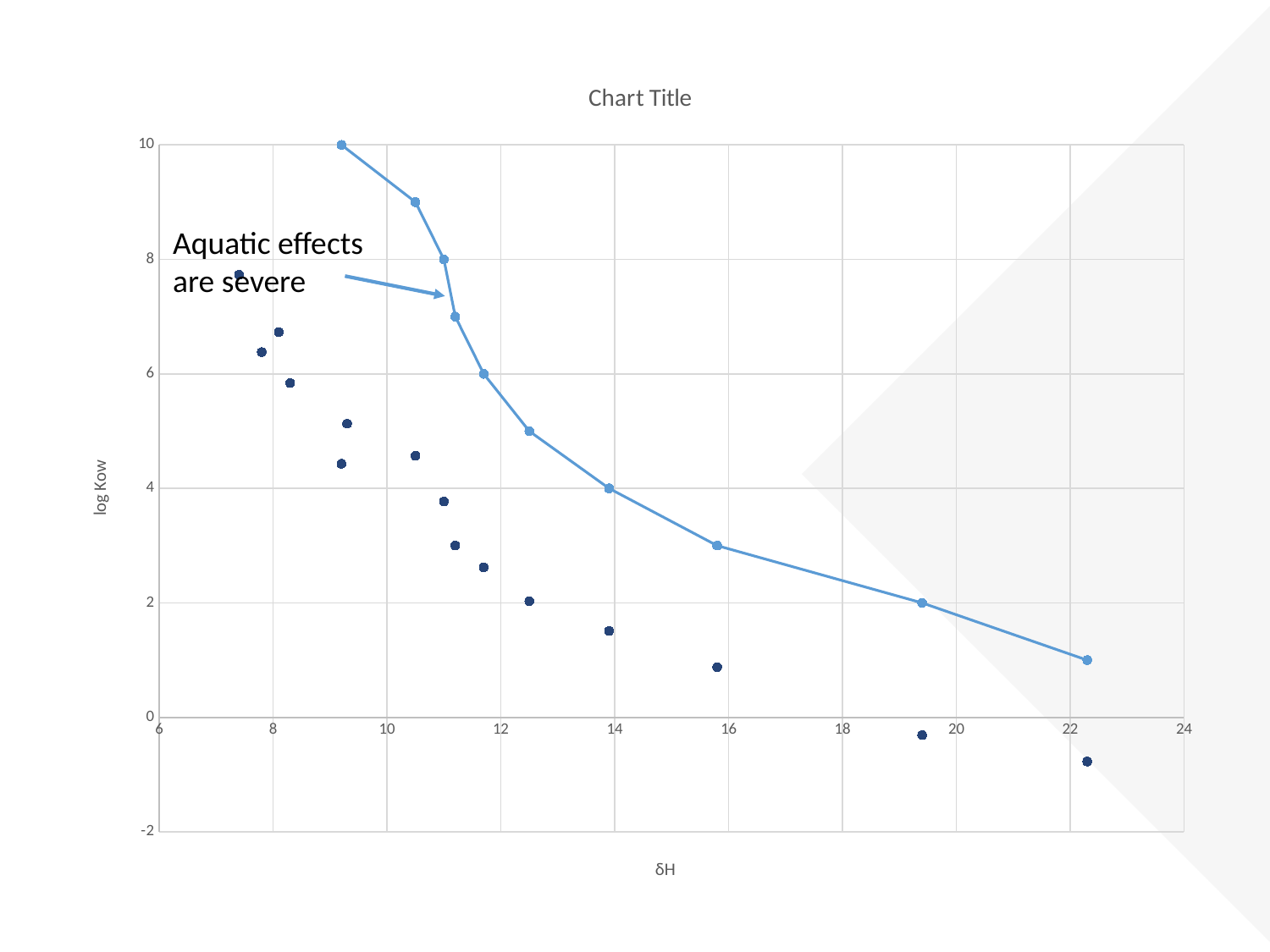
What text does the annotation with the arrow on the chart say? Aquatic effects are severe How many data series are plotted on the chart? 2 What kind of chart is shown on the slide? scatter chart Near δH = 14, which series has the higher log Kow value, the light-blue line or the dark-blue scatter points? the light-blue line Is the log Kow value of the dark-blue point near δH = 16 greater or less than 2? less Do the values of the light-blue line series rise or fall as δH increases? fall What is the title of the chart? Chart Title Do the dark-blue scatter points rise or fall as δH increases? fall How many points are on the light-blue line series? 10 What is the highest log Kow value reached by the light-blue line series? 10 Is the log Kow value of the light-blue line point near δH = 22 greater or less than 2? less